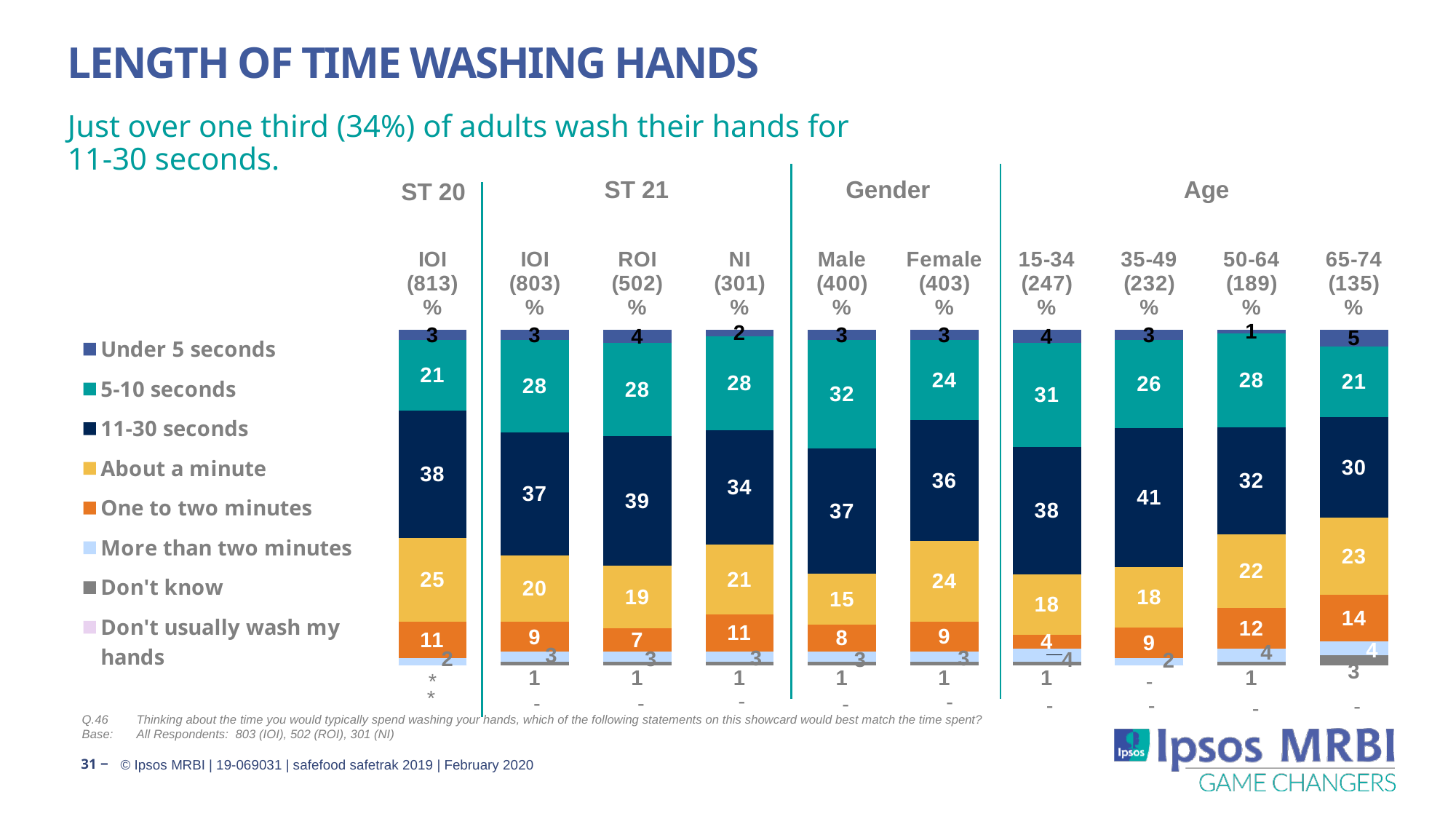
What is the value for 5-10 seconds among Males? 32 Which group has the highest value for One to two minutes? 65-74 What kind of chart is shown on the slide? Stacked bar chart Which group has the lowest value for 11-30 seconds? 65-74 What is the difference between Male and Female for 5-10 seconds? 8 Which group has the highest value for 11-30 seconds? 35-49 Which is larger for About a minute, Male or Female? Female What is the value for 11-30 seconds in the 35-49 age group? 41 What is the value for One to two minutes in the 65-74 age group? 14 What is the title of the slide? LENGTH OF TIME WASHING HANDS How many bars (groups) are shown in the chart? 10 How many series does the legend list? 8